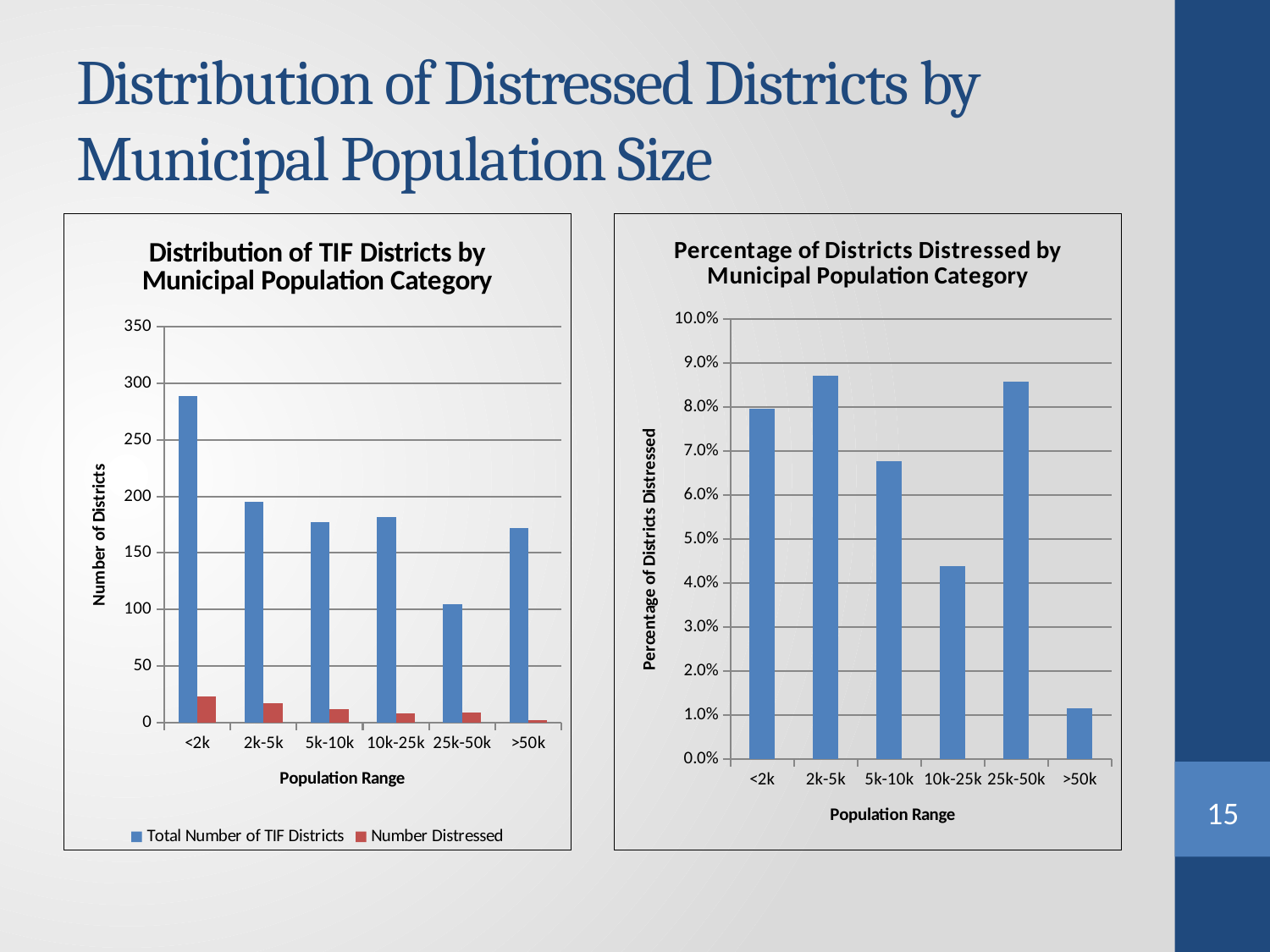
In the left chart, 'Distribution of TIF Districts by Municipal Population Category', which population range has the highest Total Number of TIF Districts? <2k In the right chart, 'Percentage of Districts Distressed by Municipal Population Category', is the value for >50k greater or less than 2.0%? less What type of chart is the left chart, 'Distribution of TIF Districts by Municipal Population Category'? bar chart In the left chart, 'Distribution of TIF Districts by Municipal Population Category', which is larger: the Total Number of TIF Districts for 2k-5k or for 25k-50k? 2k-5k In the left chart, 'Distribution of TIF Districts by Municipal Population Category', which population range has the lowest Total Number of TIF Districts? 25k-50k How many series does the legend of the left chart, 'Distribution of TIF Districts by Municipal Population Category', list? 2 How many population range categories are shown on the right chart, 'Percentage of Districts Distressed by Municipal Population Category'? 6 In the left chart, 'Distribution of TIF Districts by Municipal Population Category', is the Total Number of TIF Districts for <2k greater or less than 250? greater In the right chart, 'Percentage of Districts Distressed by Municipal Population Category', which population range has the lowest percentage? >50k In the right chart, 'Percentage of Districts Distressed by Municipal Population Category', which is larger: the value for <2k or for 10k-25k? <2k In the left chart, 'Distribution of TIF Districts by Municipal Population Category', is the Total Number of TIF Districts for 25k-50k greater or less than 150? less